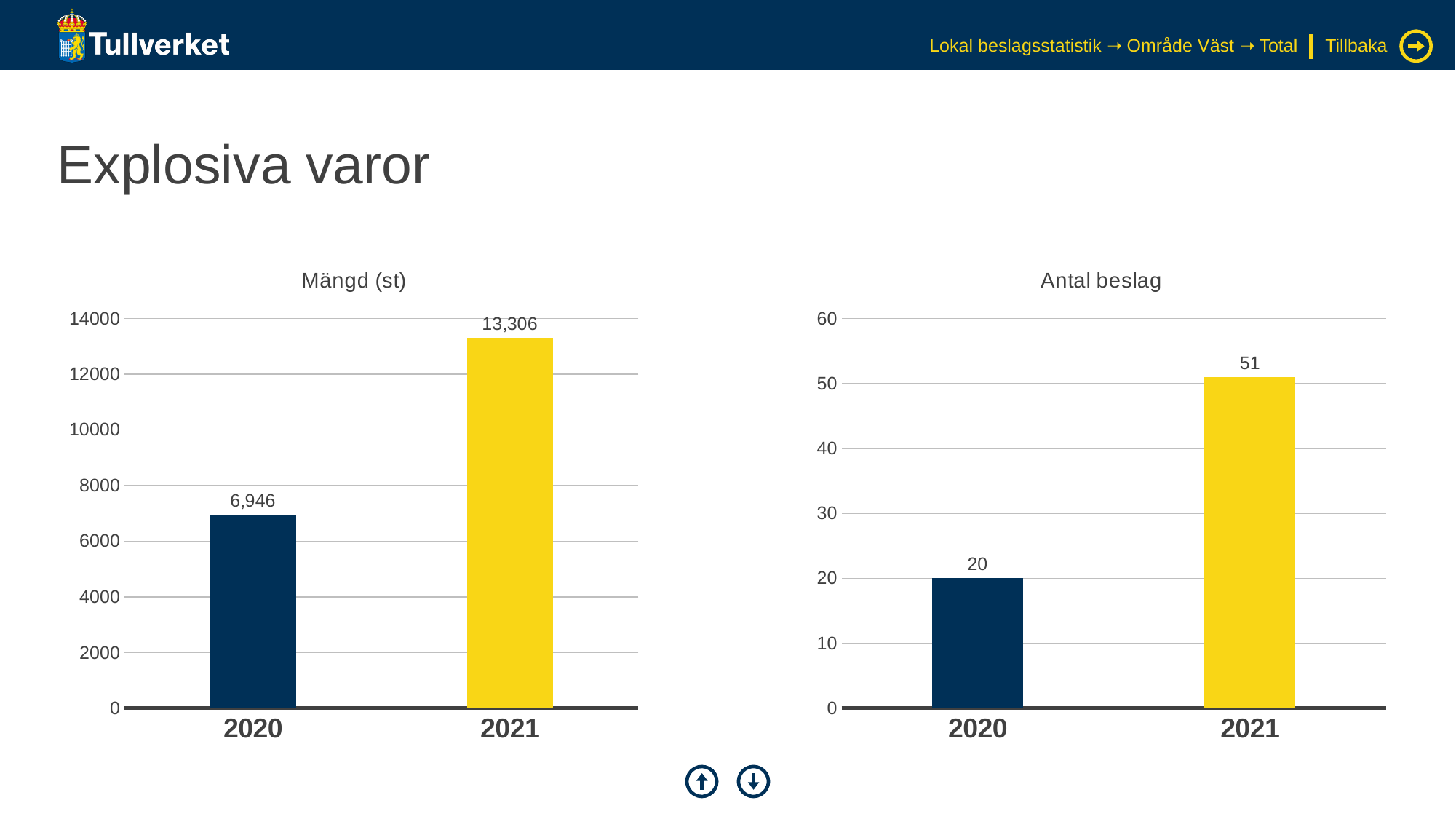
In the 'Antal beslag' chart, what is the value for 2020? 20 In the 'Antal beslag' chart, is the value for 2021 greater or less than 40? greater In the 'Mängd (st)' chart, do the values rise or fall from 2020 to 2021? rise What kind of chart is the 'Antal beslag' chart? bar chart In the 'Mängd (st)' chart, what is the difference between the 2021 and 2020 values? 6,360 In the 'Antal beslag' chart, which year has the lowest value? 2020 In the 'Mängd (st)' chart, which year has the highest value? 2021 In the 'Antal beslag' chart, what is the value for 2021? 51 How many categories are shown on the x axis of the 'Mängd (st)' chart? 2 In the 'Antal beslag' chart, what is the difference between the 2021 and 2020 values? 31 In the 'Mängd (st)' chart, what is the value for 2021? 13,306 In the 'Mängd (st)' chart, what is the value for 2020? 6,946